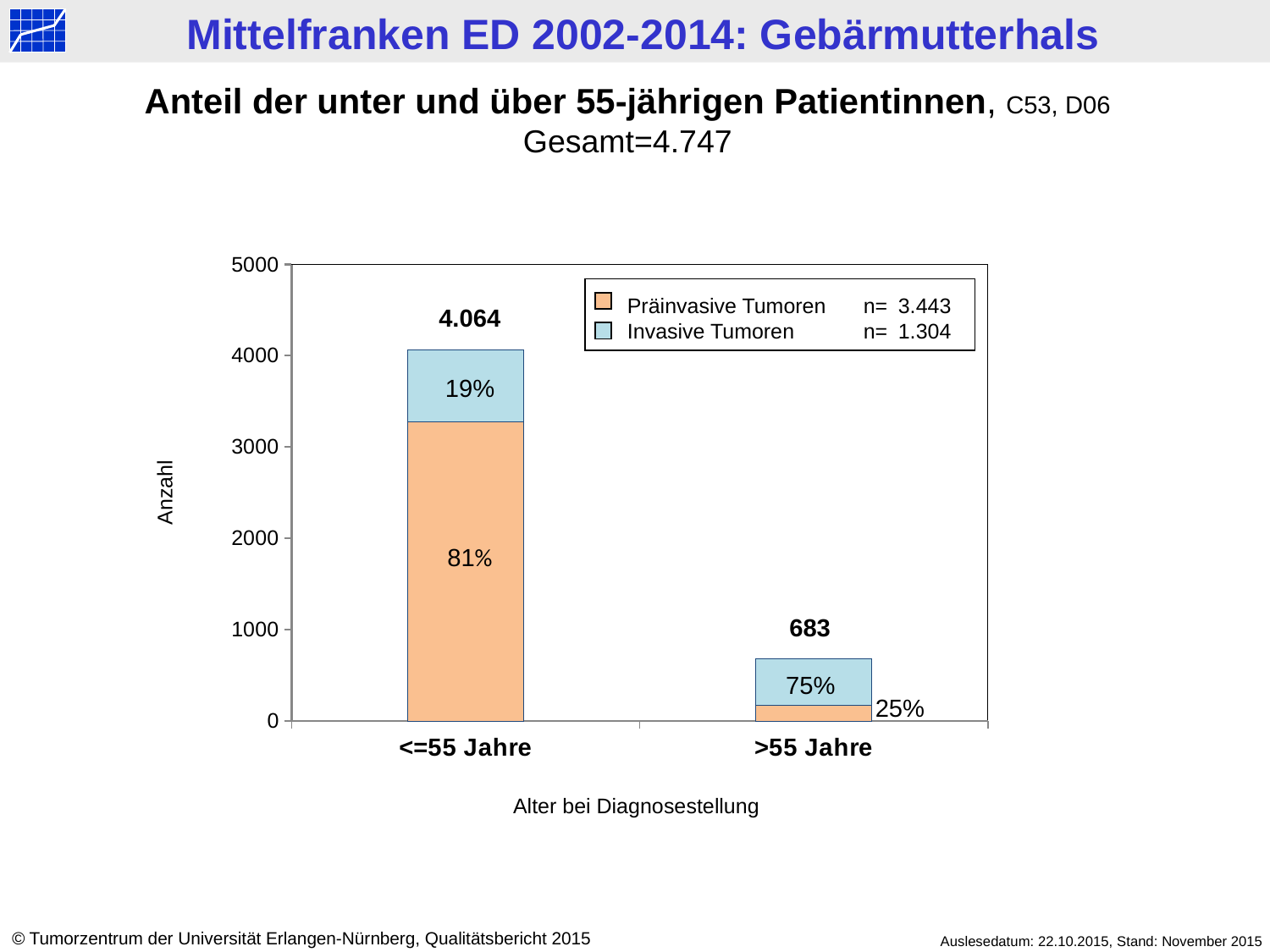
Is the total for >55 Jahre greater or less than 1000? less What percentage of the <=55 Jahre bar is Invasive Tumoren? 19% What percentage of the >55 Jahre bar is Invasive Tumoren? 75% What is the difference between the totals for <=55 Jahre and >55 Jahre? 3.381 What percentage of the <=55 Jahre bar is Präinvasive Tumoren? 81% How many series does the legend list? 2 What is the total labelled above the bar for <=55 Jahre? 4.064 What percentage of the >55 Jahre bar is Präinvasive Tumoren? 25% Which age group has the higher total number of patients? <=55 Jahre According to the legend, what is n for Invasive Tumoren? 1.304 What is the total labelled above the bar for >55 Jahre? 683 What kind of chart is shown on the slide? stacked bar chart